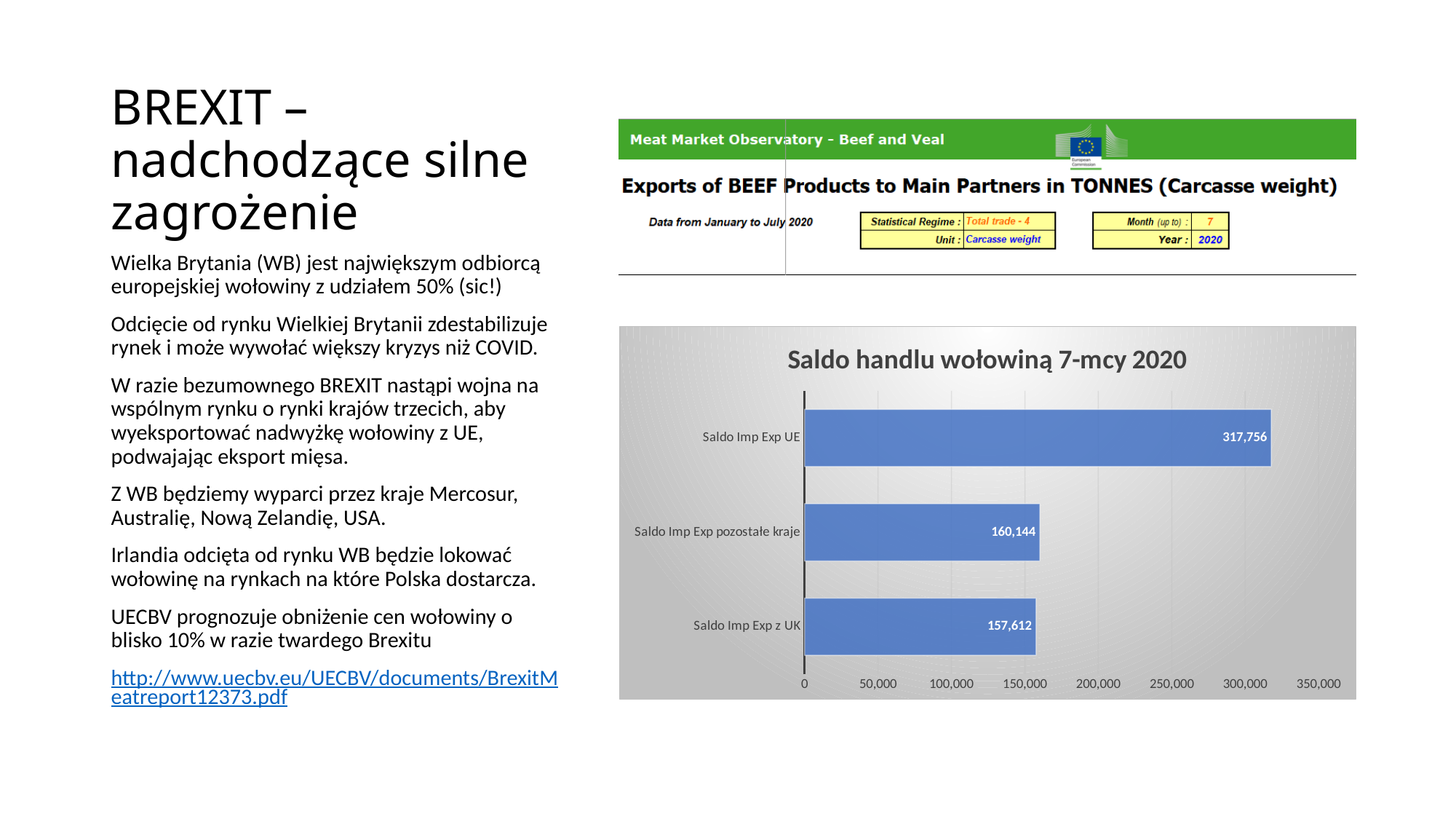
What is the value for Saldo Imp Exp UE? 317,756 What type of chart is shown on the slide? bar chart Is the value for Saldo Imp Exp pozostałe kraje greater or less than 200,000? less What is the difference between the values for Saldo Imp Exp UE and Saldo Imp Exp z UK? 160,144 What is the difference between the values for Saldo Imp Exp UE and Saldo Imp Exp pozostałe kraje? 157,612 Which is larger, the value for Saldo Imp Exp UE or the value for Saldo Imp Exp z UK? Saldo Imp Exp UE What is the difference between the values for Saldo Imp Exp pozostałe kraje and Saldo Imp Exp z UK? 2,532 Is the value for Saldo Imp Exp UE greater or less than 300,000? greater How many categories are shown in the chart? 3 What is the value for Saldo Imp Exp pozostałe kraje? 160,144 Which category has the highest value? Saldo Imp Exp UE What is the value for Saldo Imp Exp z UK? 157,612